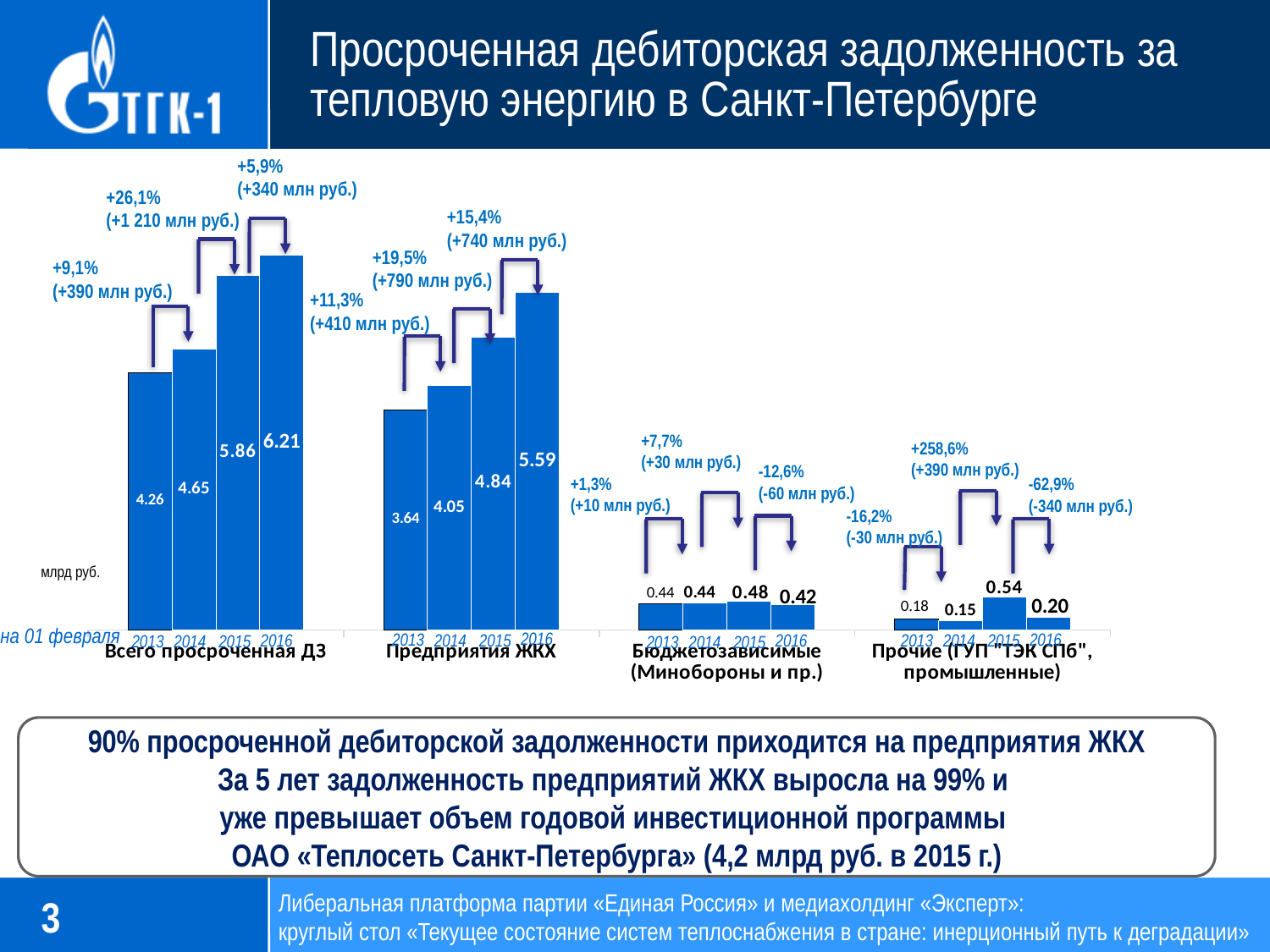
Which year has the highest value in the "Предприятия ЖКХ" group? 2016 What unit is indicated on the chart's vertical axis? млрд руб. What is the value for 2016 in the "Бюджетозависимые (Минобороны и пр.)" group? 0.42 What is the value for 2013 in the "Предприятия ЖКХ" group? 3.64 What is the difference between the 2016 and 2013 values in the "Всего просроченная ДЗ" group? 1.95 How many bars are shown in each group of the chart? 4 Which year has the lowest value in the "Прочие (ГУП "ТЭК СПб", промышленные)" group? 2014 What is the value for 2016 in the "Всего просроченная ДЗ" group? 6.21 Do the values in the "Всего просроченная ДЗ" group rise or fall from 2013 to 2016? Rise What kind of chart is shown on the slide? Bar chart Which is larger: the 2015 value for "Бюджетозависимые (Минобороны и пр.)" or the 2015 value for "Прочие (ГУП "ТЭК СПб", промышленные)"? Прочие (ГУП "ТЭК СПб", промышленные) What is the value for 2015 in the "Прочие (ГУП "ТЭК СПб", промышленные)" group? 0.54